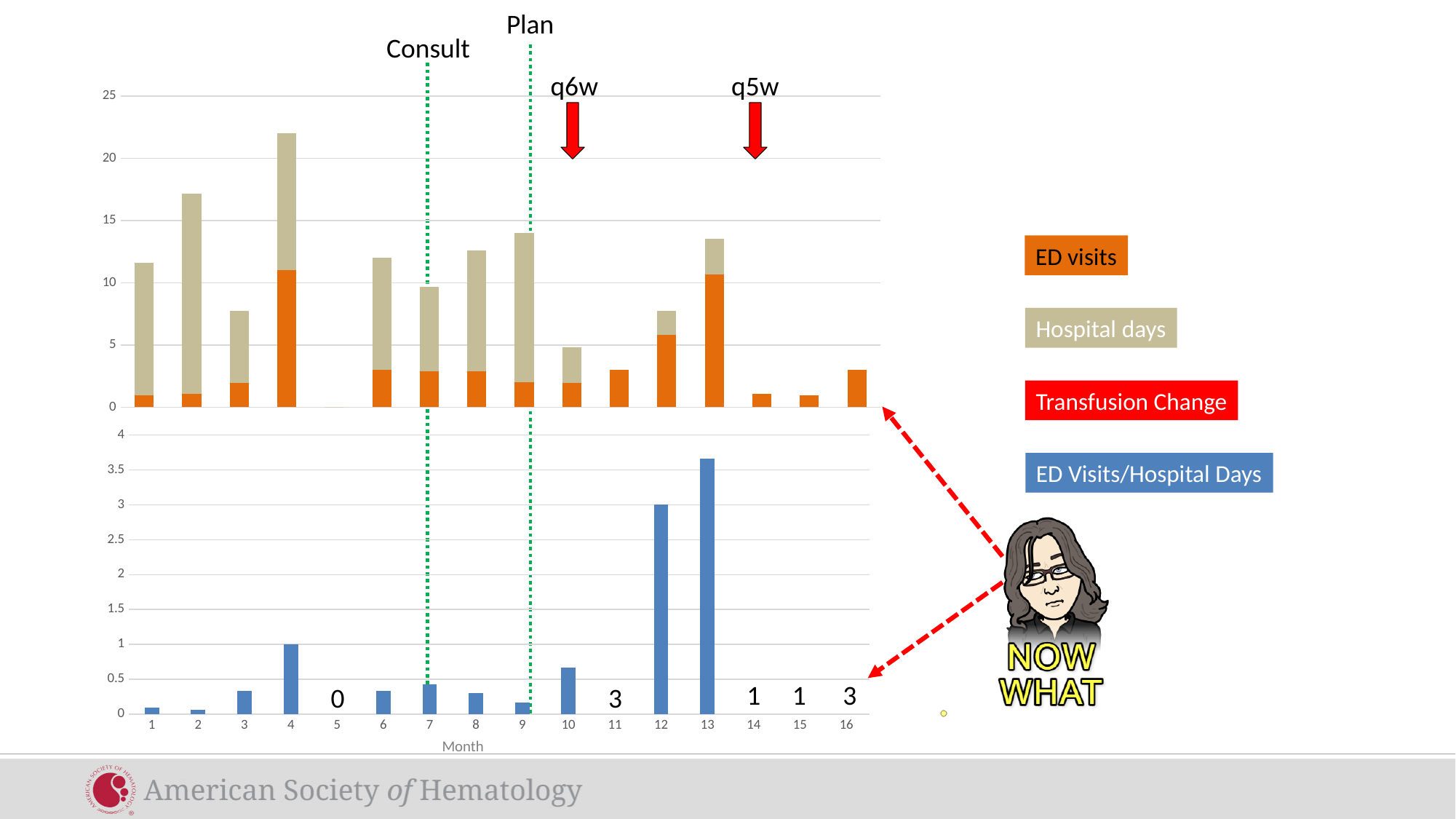
In the top stacked bar chart, is the total for month 4 greater or less than 20? greater What kind of chart is the top chart on the slide? bar chart In the bottom chart (ED Visits/Hospital Days), is the value for month 13 greater or less than 3.5? greater How many months are shown along the x axis of the charts? 16 In the top stacked bar chart, which month has more ED visits, month 4 or month 1? month 4 How many entries does the legend on the right of the slide list? 4 In the bottom chart (ED Visits/Hospital Days), which month has the highest bar? 13 What is the title of the x axis on the bottom chart? Month In the top stacked bar chart, is the total for month 1 greater or less than 10? greater In the top stacked bar chart, which month has the tallest bar? 4 In the bottom chart (ED Visits/Hospital Days), what is the value for month 12? 3